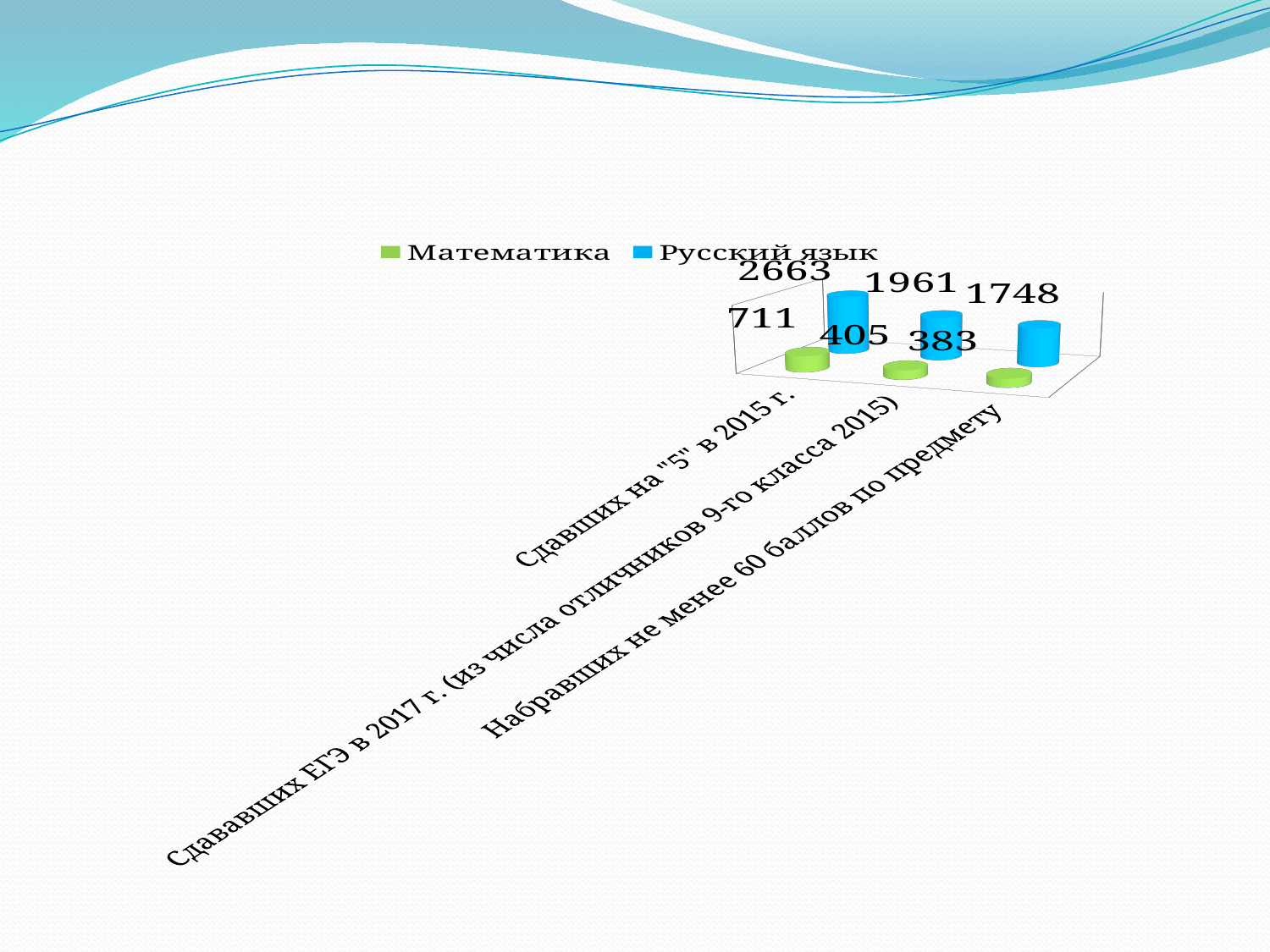
What is the difference between the Русский язык values for Сдававших ЕГЭ в 2017 г. and Набравших не менее 60 баллов по предмету? 213 Which is larger: the Математика value for Сдававших ЕГЭ в 2017 г. or the Математика value for Набравших не менее 60 баллов по предмету? Сдававших ЕГЭ в 2017 г. What is the value for Русский язык in the category Сдавших на "5" в 2015 г.? 2663 Which category has the highest value for Русский язык? Сдавших на "5" в 2015 г. What is the value for Математика in the category Набравших не менее 60 баллов по предмету? 383 What kind of chart is shown on the slide? Bar chart What is the value for Русский язык in the category Сдававших ЕГЭ в 2017 г. (из числа отличников 9-го класса 2015)? 1961 Which category has the lowest value for Математика? Набравших не менее 60 баллов по предмету What is the value for Математика in the category Сдавших на "5" в 2015 г.? 711 What is the difference between the Русский язык and Математика values in the category Сдавших на "5" в 2015 г.? 1952 How many categories are shown on the chart? 3 How many series does the legend list? 2